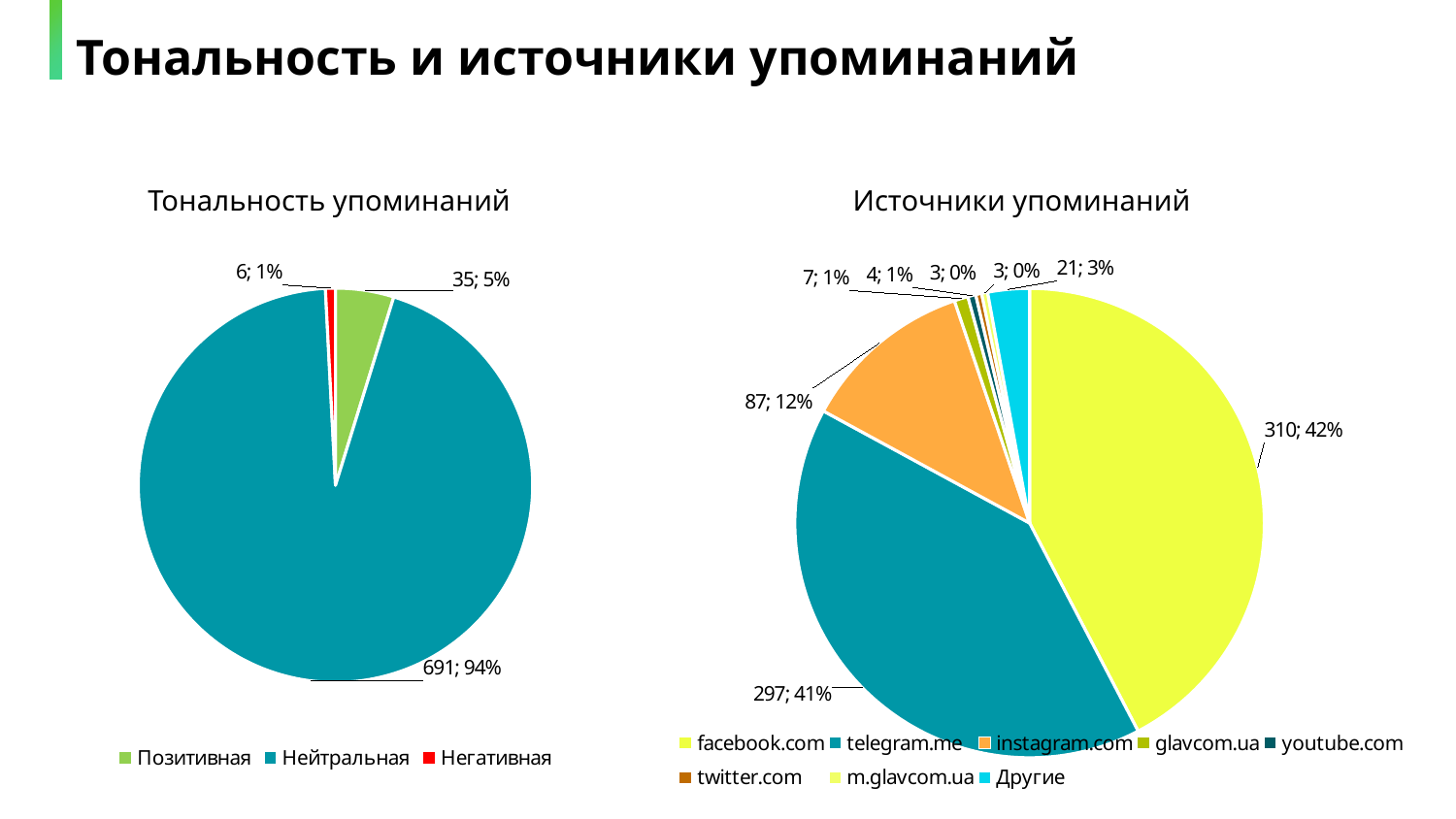
In the 'Источники упоминаний' pie chart, what is the difference between the facebook.com count and the telegram.me count? 13 In the 'Источники упоминаний' pie chart, what value is shown for facebook.com? 310; 42% In the 'Источники упоминаний' pie chart, which source has the largest slice? facebook.com In the 'Тональность упоминаний' pie chart, what share of the pie does Позитивная have? 5% In the 'Тональность упоминаний' pie chart, what is the difference between the Позитивная count and the Негативная count? 29 In the 'Источники упоминаний' pie chart, what value is shown for instagram.com? 87; 12% In the 'Источники упоминаний' pie chart, which is larger: instagram.com or Другие? instagram.com How many entries does the legend of the 'Источники упоминаний' chart list? 8 In the 'Тональность упоминаний' pie chart, what value is shown for Нейтральная? 691; 94% In the 'Тональность упоминаний' pie chart, which category is the smallest? Негативная How many series does the legend of the 'Тональность упоминаний' chart list? 3 What kind of chart is 'Источники упоминаний'? Pie chart